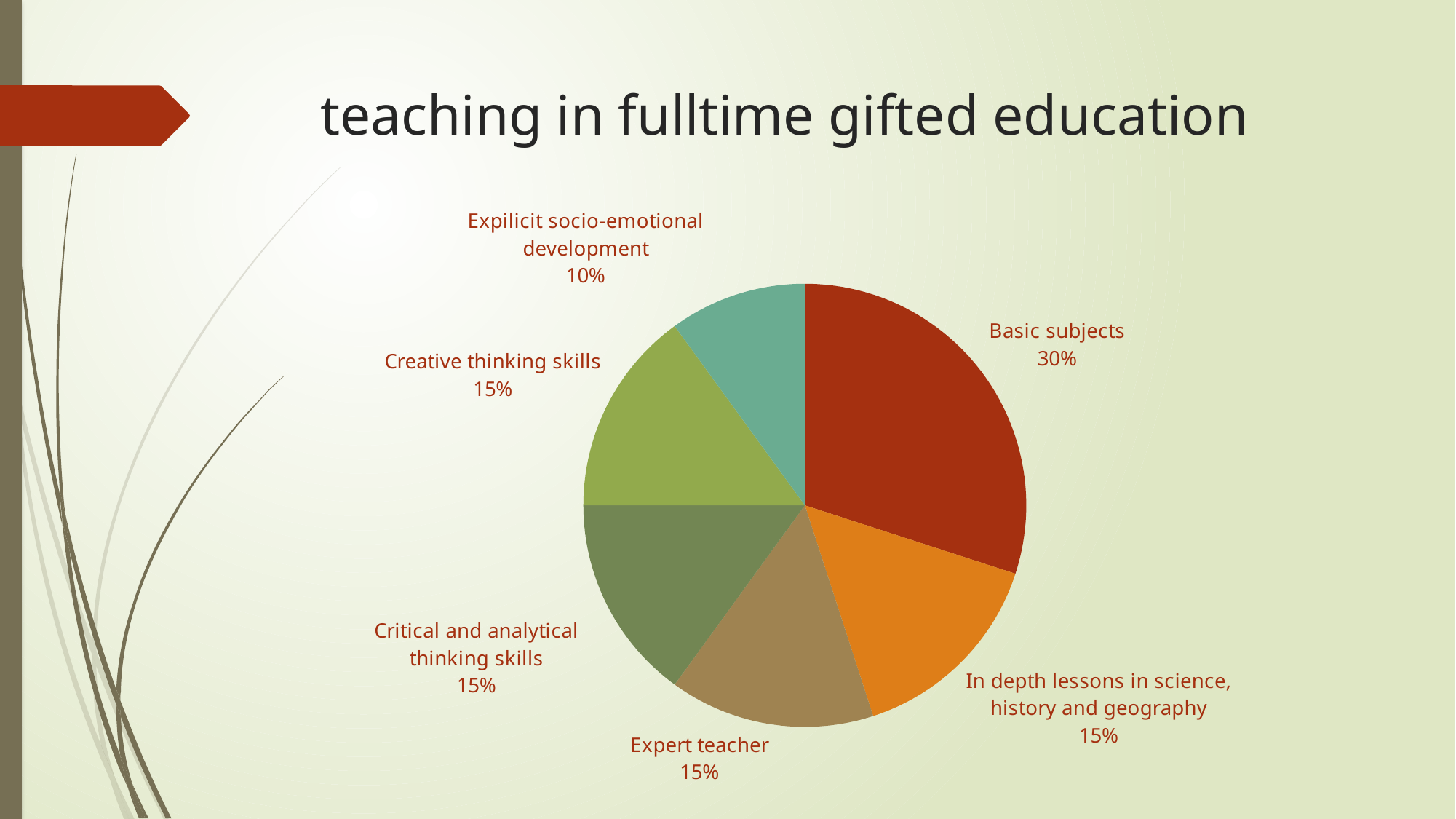
Which is larger, the share for Basic subjects or the share for Expilicit socio-emotional development? Basic subjects What share of the pie does In depth lessons in science, history and geography have? 15% Which category has the largest slice of the pie? Basic subjects How many slices does the pie chart have? 6 What is the title of the slide containing the pie chart? teaching in fulltime gifted education What share of the pie does Basic subjects have? 30% Which category has the smallest slice of the pie? Expilicit socio-emotional development What kind of chart is shown on the slide? pie chart What share of the pie does Expilicit socio-emotional development have? 10% What colour is the Basic subjects slice? dark red What is the difference between the share for Basic subjects and the share for Creative thinking skills? 15% What share of the pie does Expert teacher have? 15%